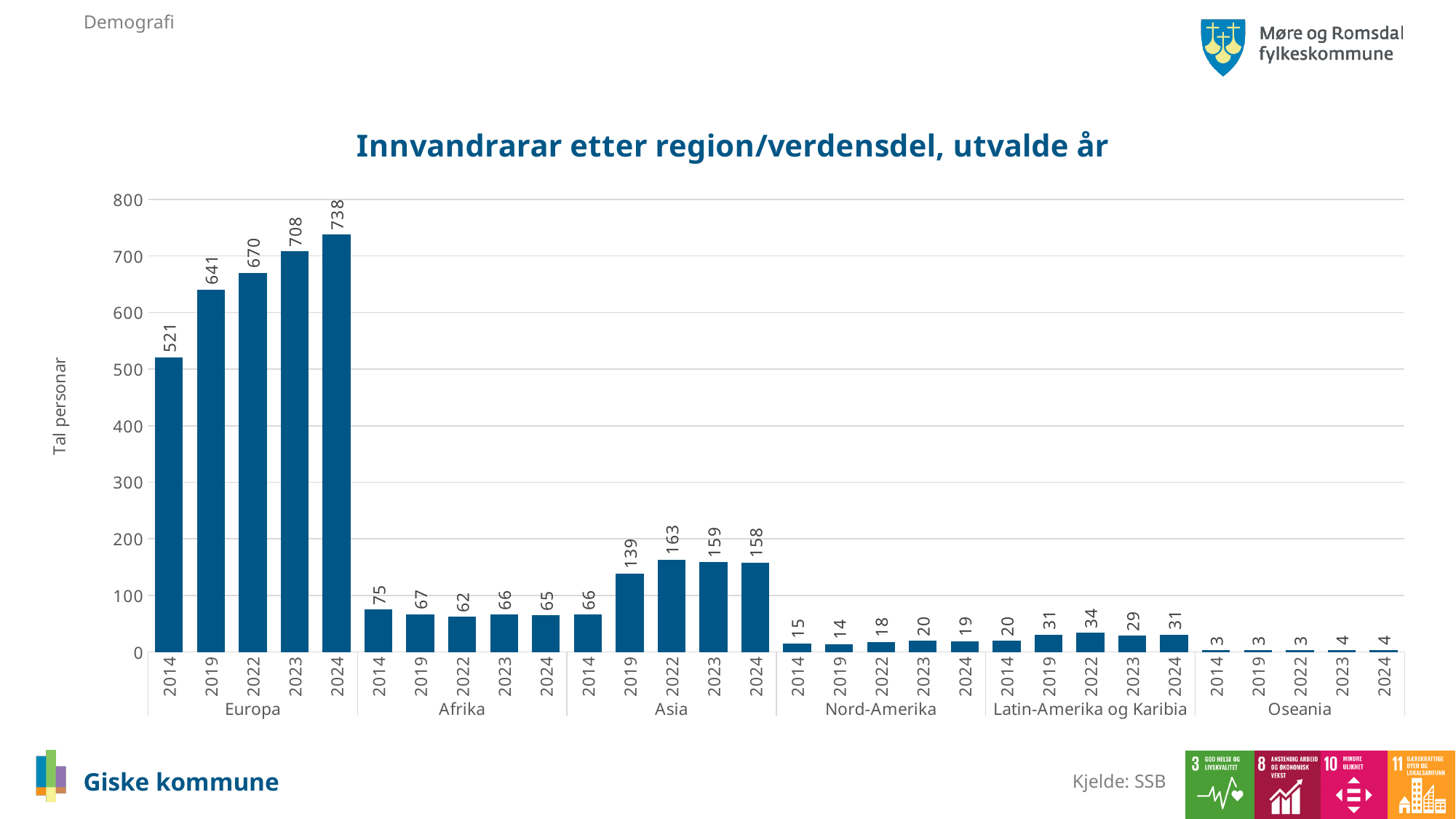
How many regions are shown on the x axis? 6 What is the difference between the Europa values for 2024 and 2014? 217 Which region has the lowest bar in 2014? Oseania What kind of chart is this? bar chart What is the value for Nord-Amerika in 2014? 15 What is the title of the chart? Innvandrarar etter region/verdensdel, utvalde år Which region has the highest bar in 2024? Europa What is the value for Asia in 2022? 163 Which is larger, the Afrika value for 2014 or the Afrika value for 2024? Afrika 2014 Is the value for Europa in 2019 greater or less than 600? greater What is the value for Europa in 2024? 738 Do the Europa values rise or fall from 2014 to 2024? rise